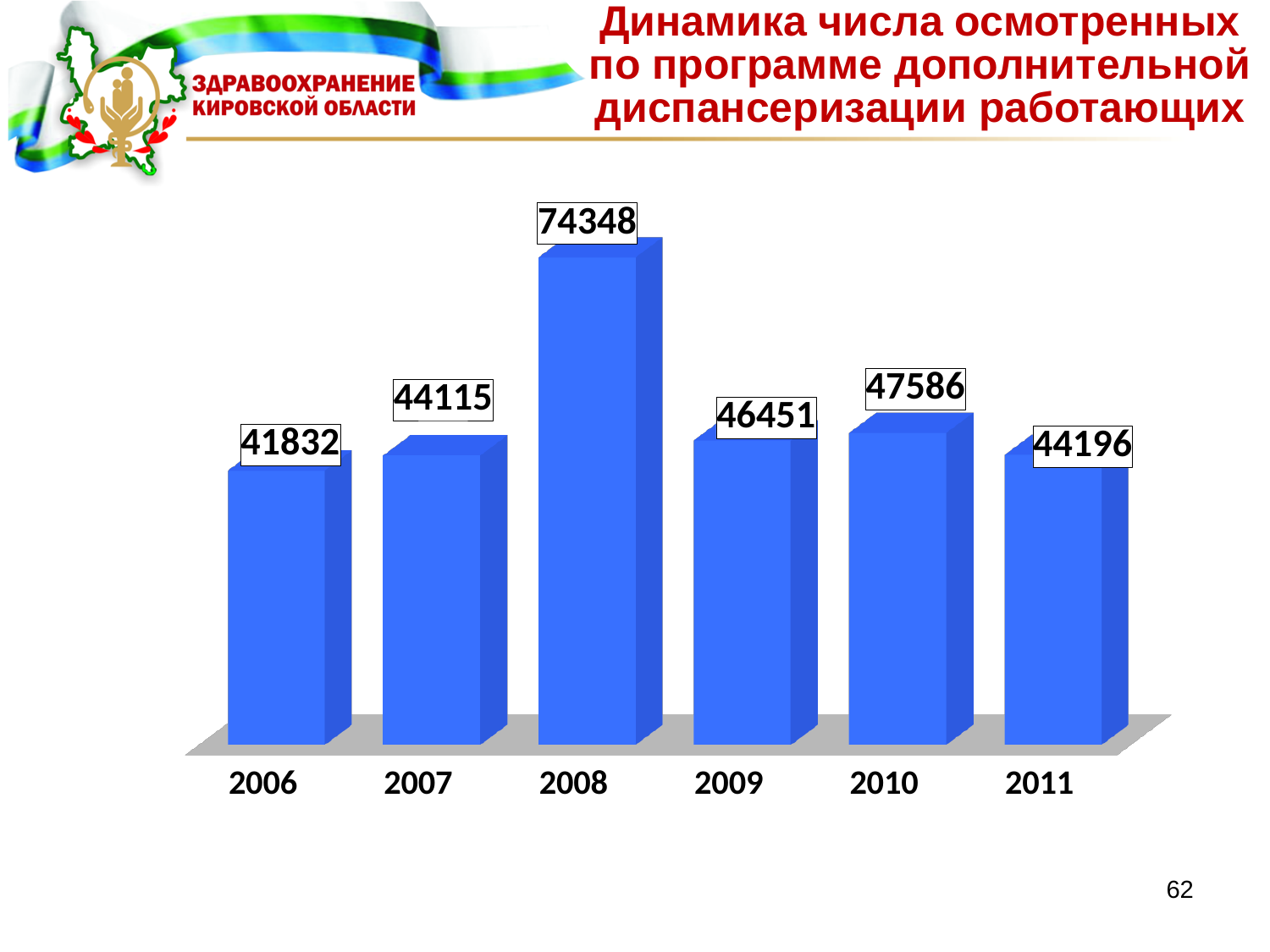
What is the difference between the values for 2007 and 2006? 2283 What is the value for 2006? 41832 Which year has the highest value? 2008 What is the value for 2008? 74348 Which year has the lowest value? 2006 Does the value rise or fall from 2010 to 2011? fall How many years are shown on the chart? 6 What is the value for 2010? 47586 Which is larger, the value for 2010 or the value for 2011? 2010 What is the title of the chart? Динамика числа осмотренных по программе дополнительной диспансеризации работающих What kind of chart is shown on the slide? bar chart What is the difference between the values for 2008 and 2009? 27897